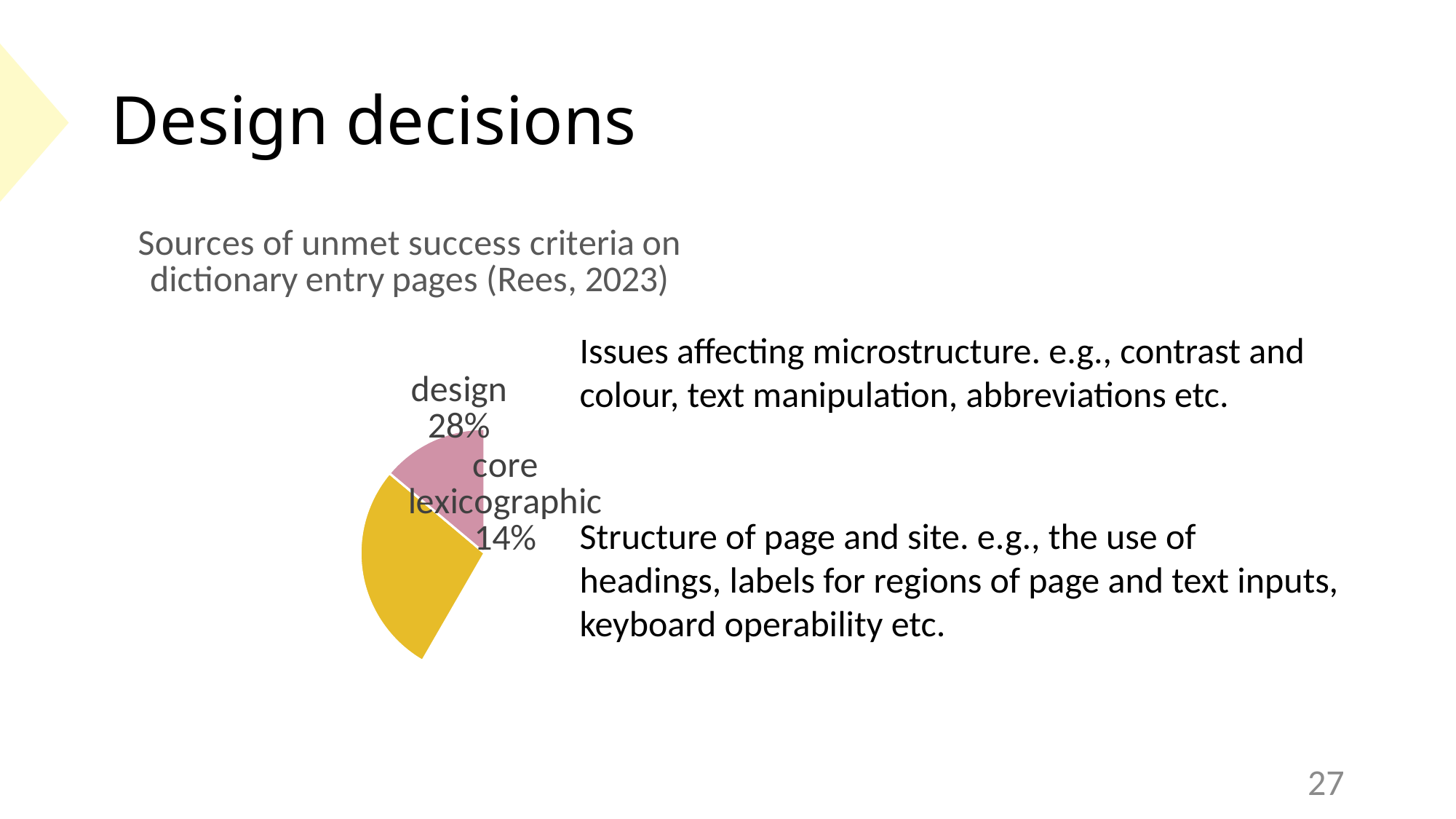
What kind of chart is shown on the slide? pie chart What colour is the design slice? yellow Which labelled slice has the largest percentage? design What is the title of the chart? Sources of unmet success criteria on dictionary entry pages (Rees, 2023) By how many percentage points does the design slice exceed the core lexicographic slice? 14 How many labelled slices are visible in the chart? 2 Which labelled slice has the smallest percentage? core lexicographic Which of the two labelled slices, design or core lexicographic, is larger? design What percentage is shown for the design slice? 28% What percentage is shown for the core lexicographic slice? 14%